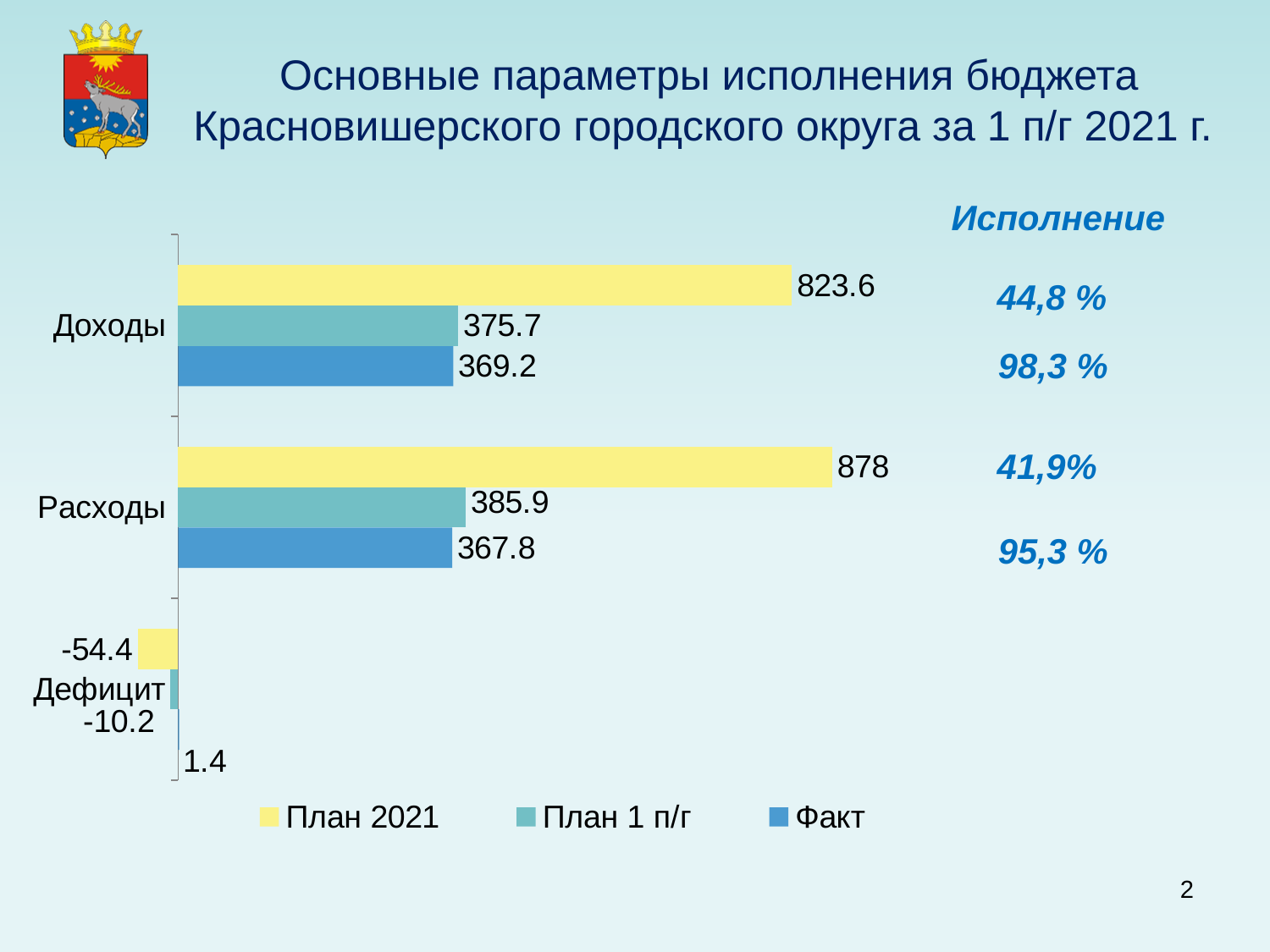
Which is larger: the Факт value for Доходы or the Факт value for Расходы? Факт value for Доходы What is the difference between the План 2021 and Факт values for Доходы? 454.4 What is the Факт value for Расходы? 367.8 What is the План 2021 value for Доходы? 823.6 What kind of chart is shown on the slide? Bar chart What is the Факт value for Дефицит? 1.4 What is the План 1 п/г value for Дефицит? -10.2 Which category has the highest План 2021 value? Расходы How many categories are shown on the chart? 3 What is the difference between the План 1 п/г values for Расходы and Доходы? 10.2 Which category has the lowest Факт value? Дефицит How many series does the legend list? 3